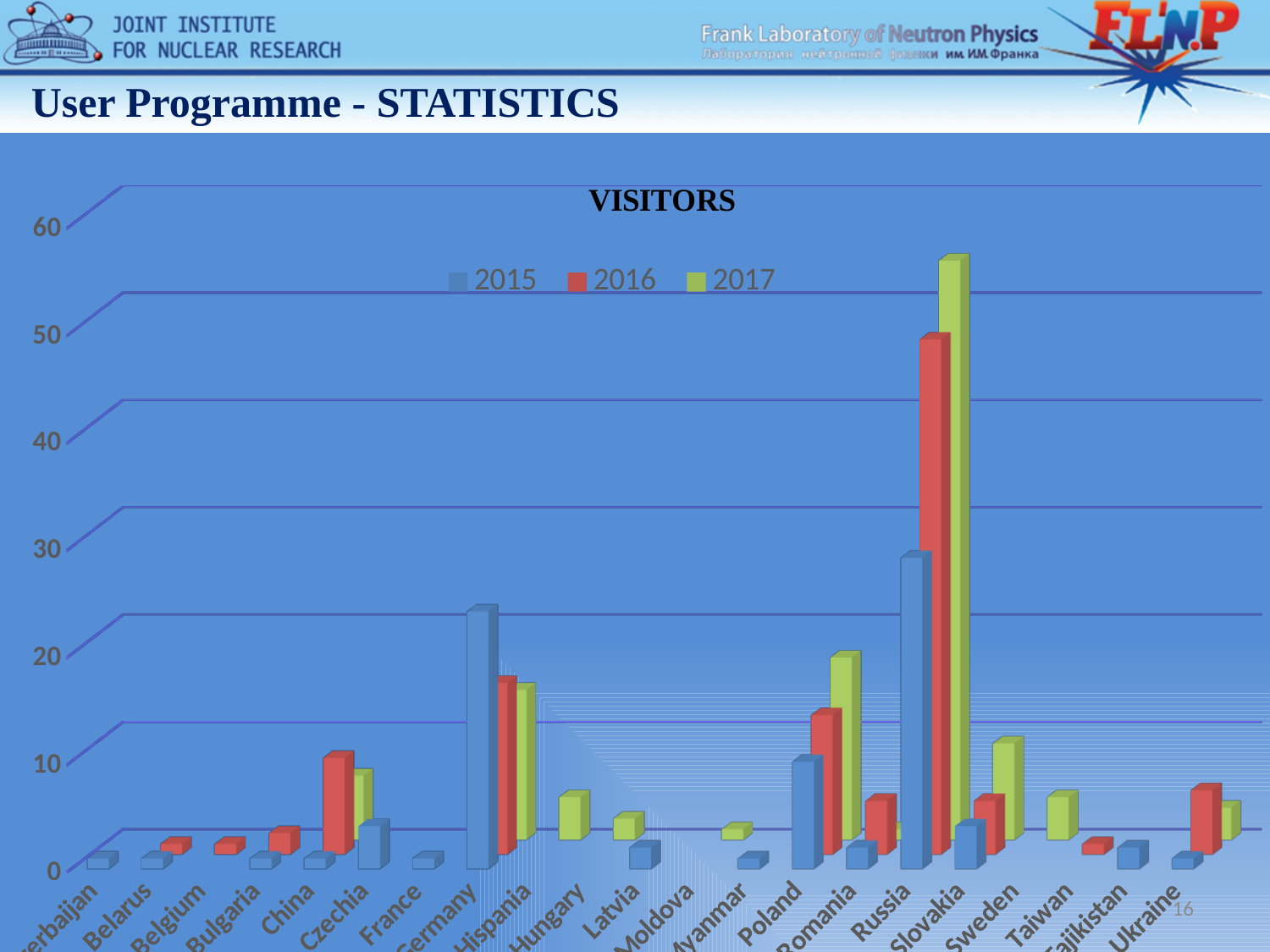
Is the 2017 value for Russia greater or less than 50? greater Which country has the highest 2015 bar in the VISITORS chart? Russia Is the 2015 value for Germany greater or less than 20? greater Which country has the highest 2016 bar in the VISITORS chart? Russia How many series does the legend of the VISITORS chart list? 3 For Germany, which series has the larger value, 2015 or 2016? 2015 What kind of chart is shown on the slide? bar chart What is the title of the chart? VISITORS Is the 2016 value for Russia greater or less than 40? greater Which country has the highest 2017 bar in the VISITORS chart? Russia For Russia, which series has the larger value, 2016 or 2017? 2017 Which colour represents the 2017 series in the chart? green